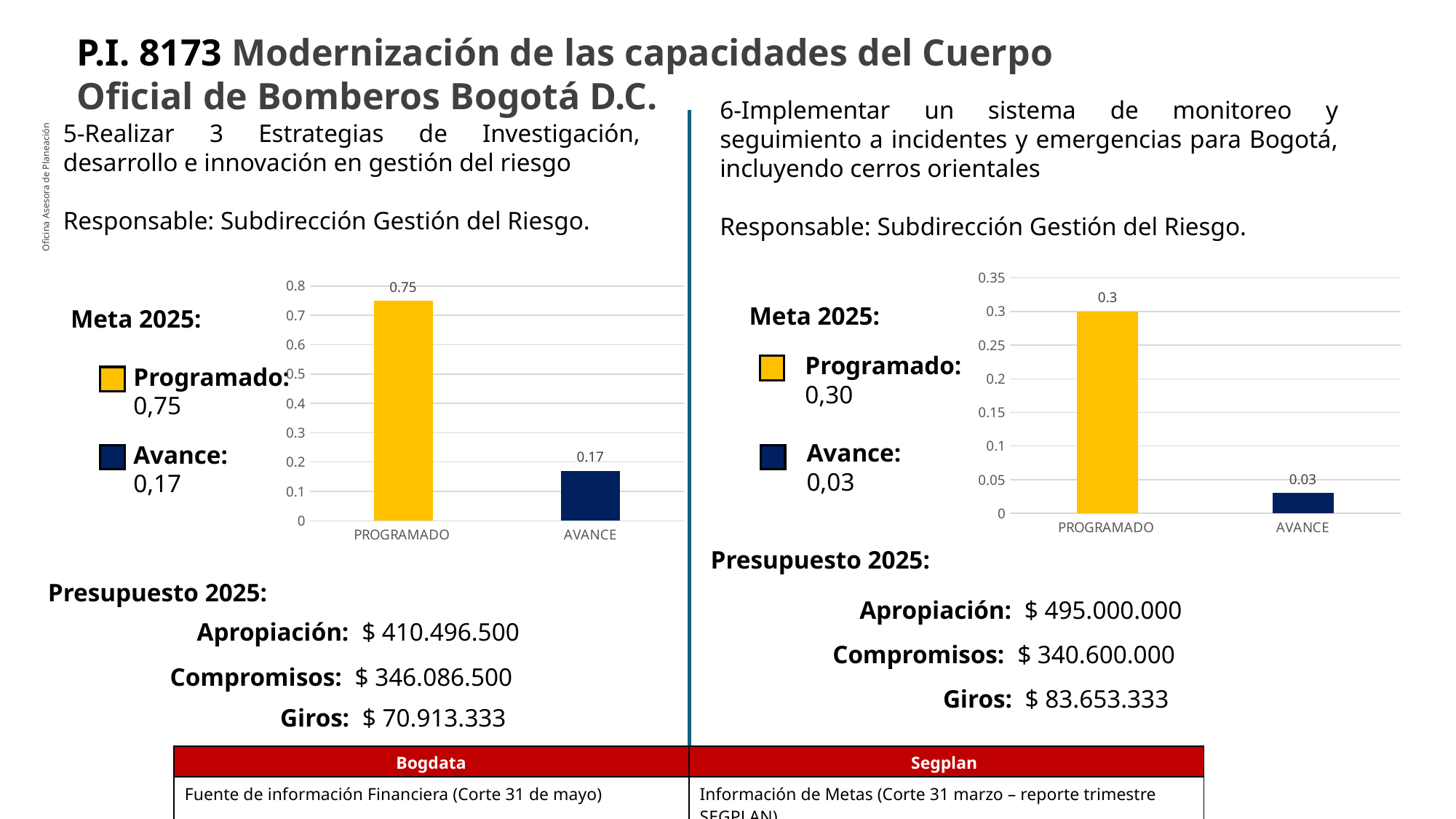
In the right chart, what is the value for AVANCE? 0.03 In the left chart, what is the difference between PROGRAMADO and AVANCE? 0.58 In the right chart, which category has the lowest value? AVANCE In the right chart, what is the difference between PROGRAMADO and AVANCE? 0.27 What kind of chart is the right chart? bar chart In the left chart, which category has the highest value? PROGRAMADO In the left chart, what is the value for PROGRAMADO? 0.75 In the right chart, what is the value for PROGRAMADO? 0.3 In the right chart, which is larger, PROGRAMADO or AVANCE? PROGRAMADO How many bars are shown in the left chart? 2 In the left chart, what is the value for AVANCE? 0.17 In the left chart, is the value for AVANCE greater or less than 0.2? less